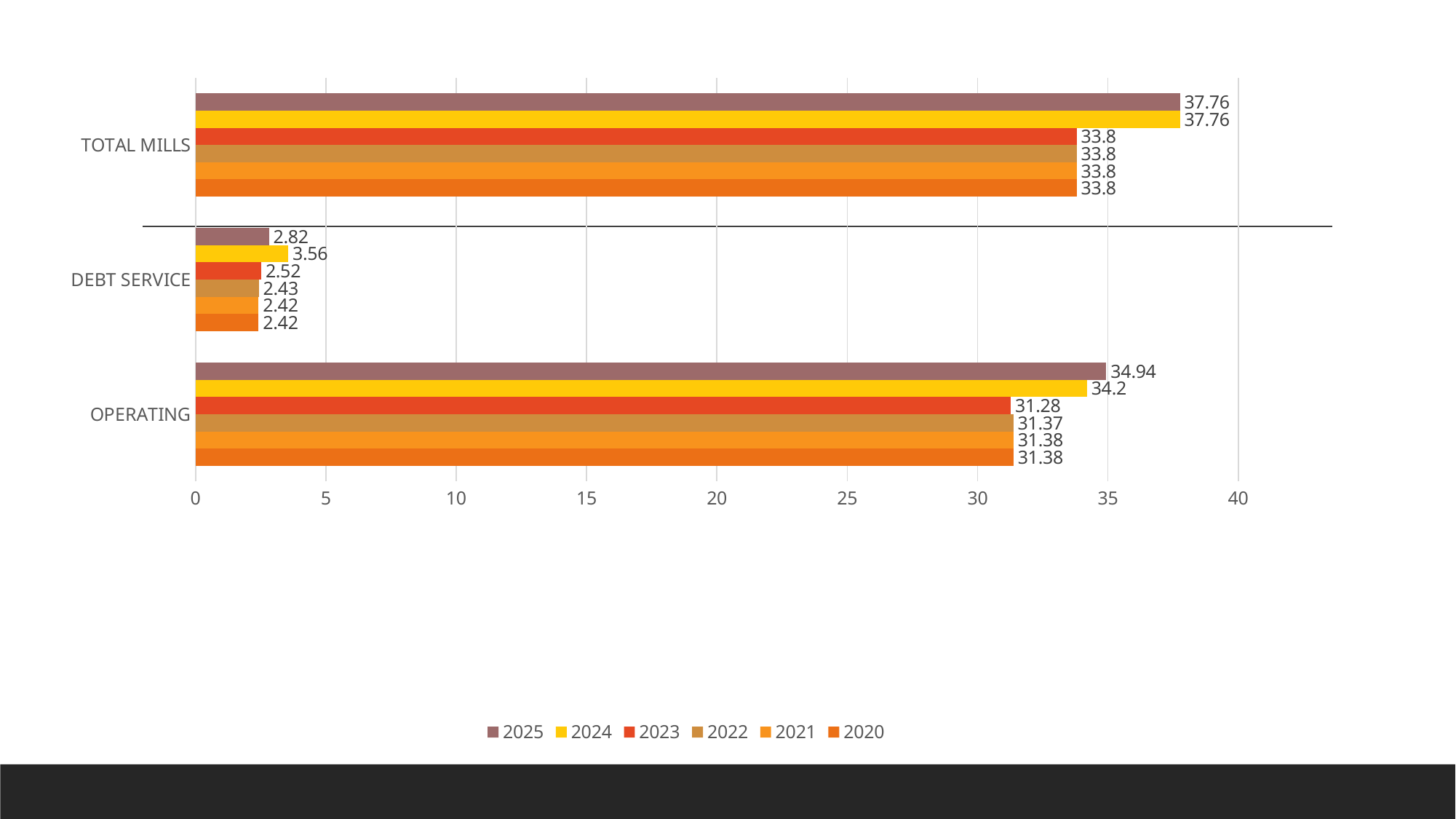
Is the TOTAL MILLS value for 2025 greater or less than 35? greater Which is larger, the DEBT SERVICE value for 2025 or for 2023? 2025 Which year has the lowest OPERATING value? 2023 Which year has the highest DEBT SERVICE value? 2024 How many series does the legend list? 6 What is the value for TOTAL MILLS in 2023? 33.8 What is the value for OPERATING in 2025? 34.94 What kind of chart is shown on the slide? bar chart How many categories are shown on the vertical axis? 3 What is the value for DEBT SERVICE in 2024? 3.56 What is the difference between the OPERATING values for 2025 and 2024? 0.74 What is the value for DEBT SERVICE in 2020? 2.42